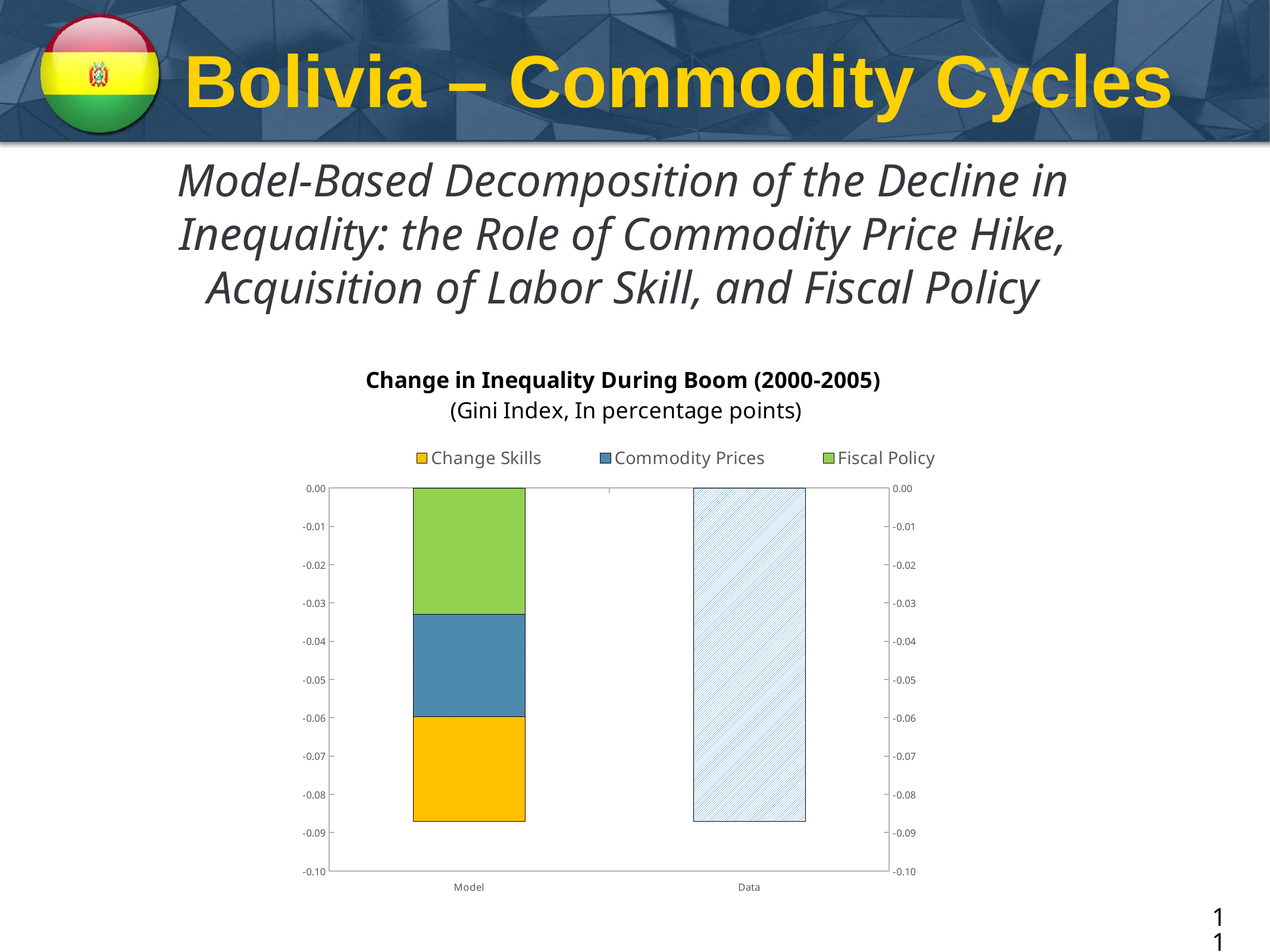
What kind of chart is shown on the slide? stacked bar chart How many series does the chart legend list? 3 What is the title of the chart? Change in Inequality During Boom (2000-2005) Is the Fiscal Policy contribution in the Model bar greater or less than -0.02? less Which series appears at the top of the Model stacked bar, closest to 0.00? Fiscal Policy How many categories are shown on the x axis of the chart? 2 Is the total value of the Model bar greater or less than -0.10? greater What are the two categories on the x axis of the chart? Model and Data Is the total value of the Model bar greater or less than -0.05? less